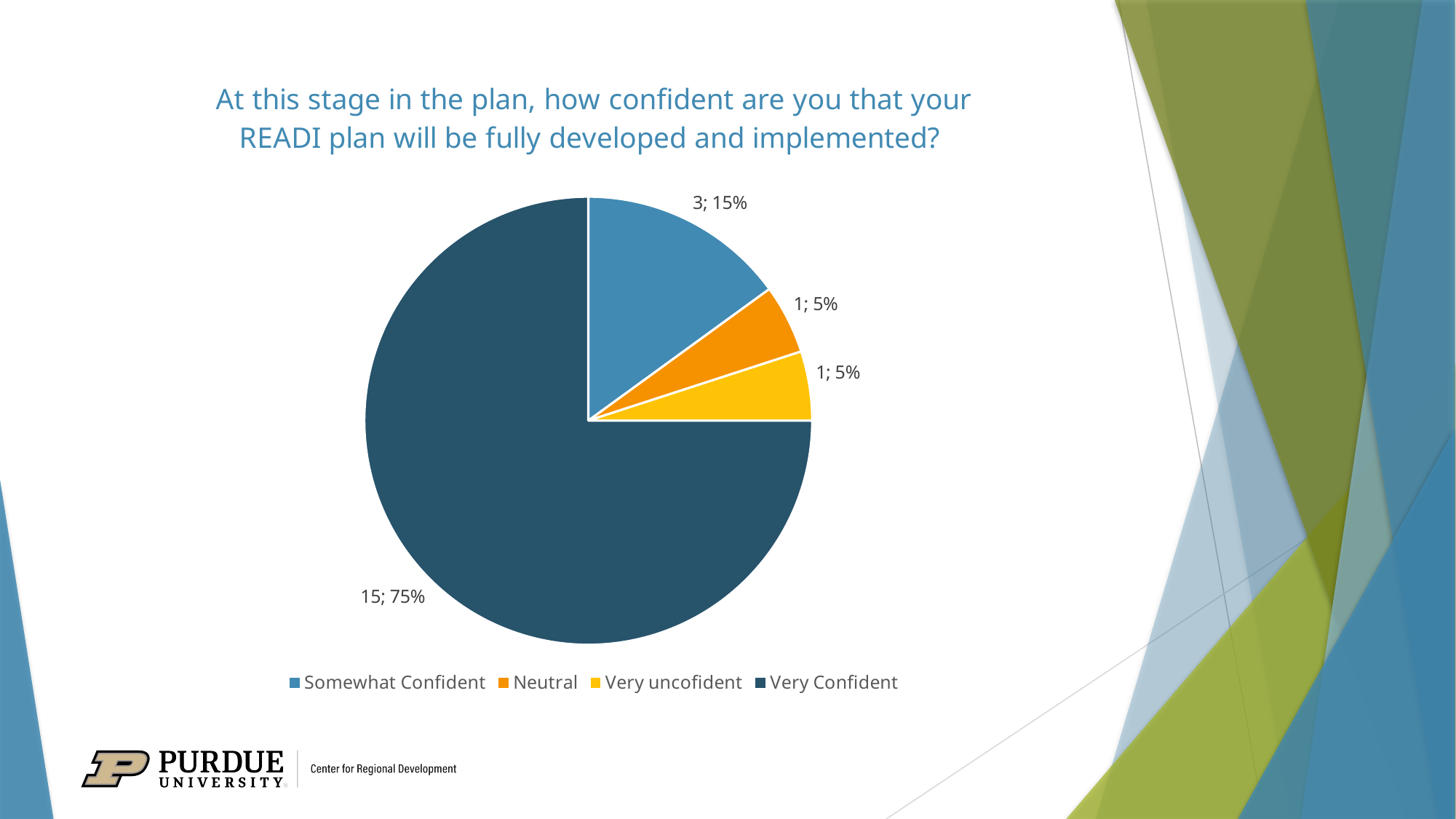
How many slices does the pie chart have? 4 What share of the pie is Somewhat Confident? 15% How many entries does the legend list? 4 What is the title of the chart? At this stage in the plan, how confident are you that your READI plan will be fully developed and implemented? Which category has the largest slice? Very Confident How many respondents are Very Confident? 15 What is the difference in count between Very Confident and Somewhat Confident? 12 Which is larger, Somewhat Confident or Neutral? Somewhat Confident What share of the pie is Very Confident? 75% What kind of chart is shown on the slide? pie chart What share of the pie is Neutral? 5% How many respondents are Somewhat Confident? 3